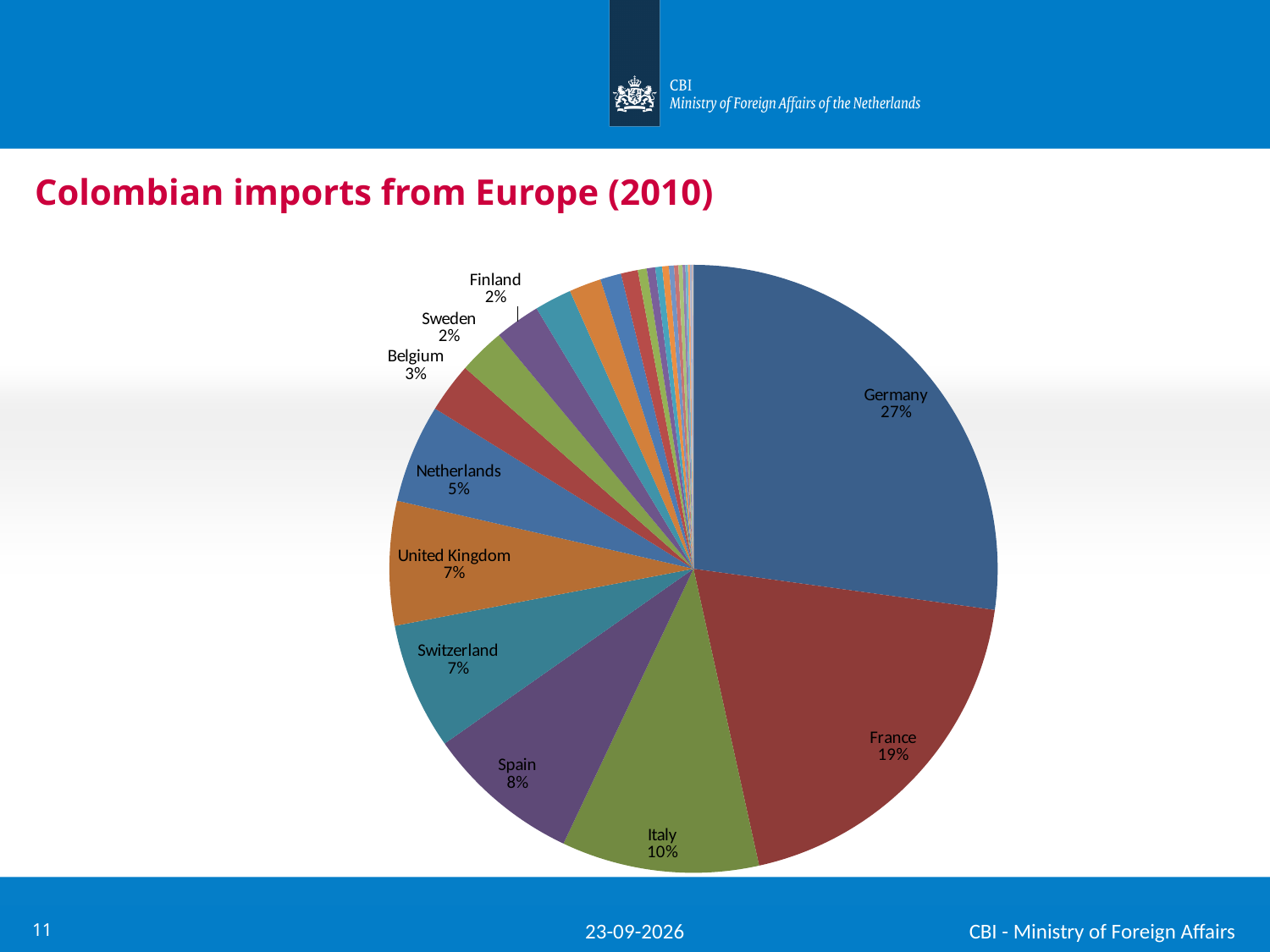
What is the title of the chart? Colombian imports from Europe (2010) Which is larger, the share for Spain or the share for the Netherlands? Spain What share of Colombian imports from Europe comes from Germany? 27% What is the value shown for the Netherlands? 5% What is the difference between the shares of Germany and France? 8% What is the combined share of Sweden and Finland? 4% What is the value shown for Belgium? 3% What kind of chart is shown on the slide? pie chart What is the value shown for Italy? 10% Which country has the largest slice of the pie? Germany What is the value shown for France? 19% What is the value shown for Spain? 8%